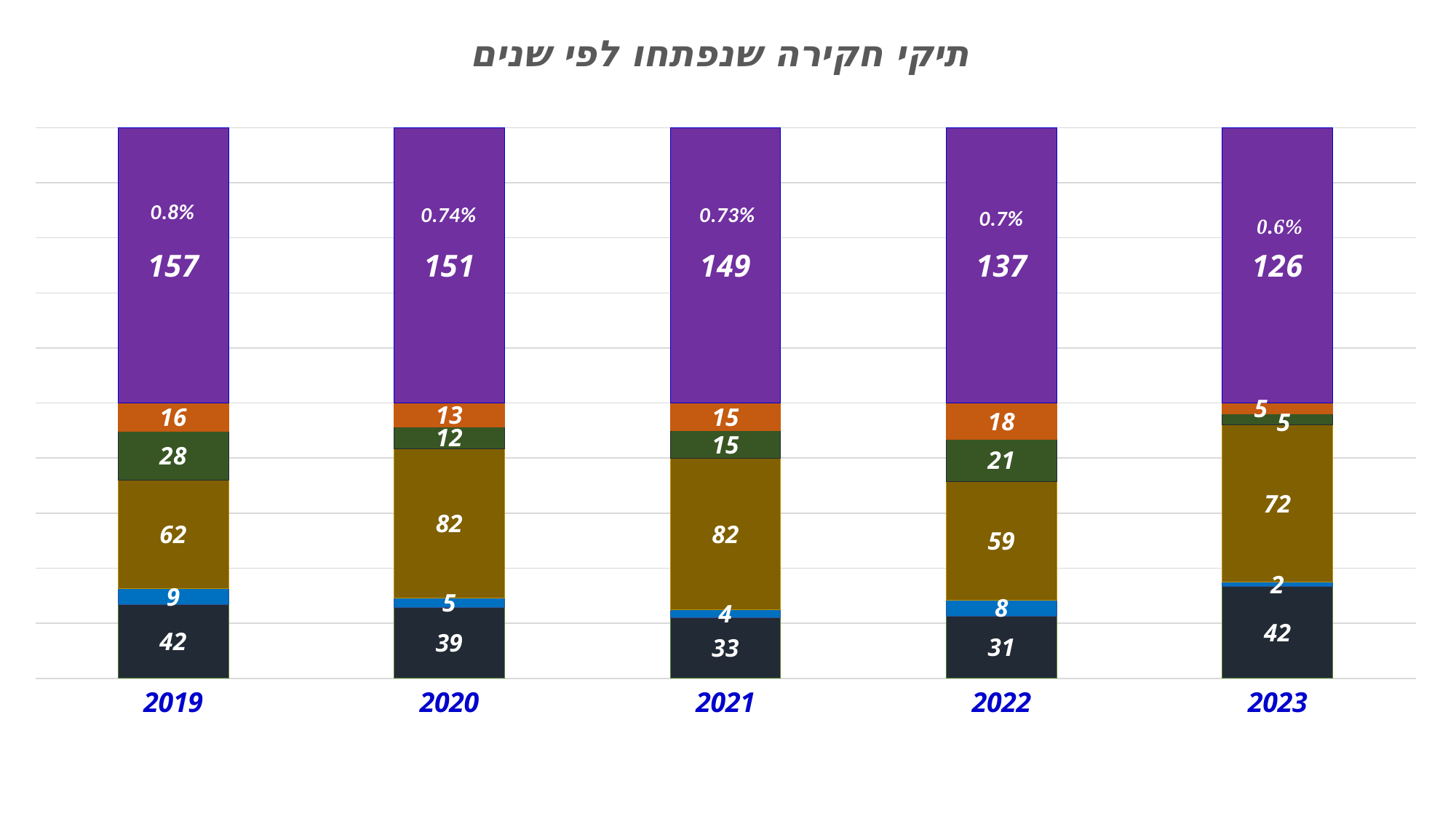
What is the value of the dark navy bottom segment for 2021? 33 Which is larger, the gold segment for 2019 or the gold segment for 2023? 2023 What is the value of the gold segment for 2020? 82 What kind of chart is shown on the slide? Stacked bar chart What is the value of the green segment for 2022? 21 What is the total number printed in the purple segment for 2019? 157 Which year has the highest total printed in the purple segment? 2019 What is the difference between the totals printed for 2019 and 2023? 31 What percentage is printed in the purple segment for 2023? 0.6% Which year has the lowest total printed in the purple segment? 2023 Do the totals printed in the purple segments rise or fall from 2019 to 2023? Fall How many years are shown along the x axis? 5